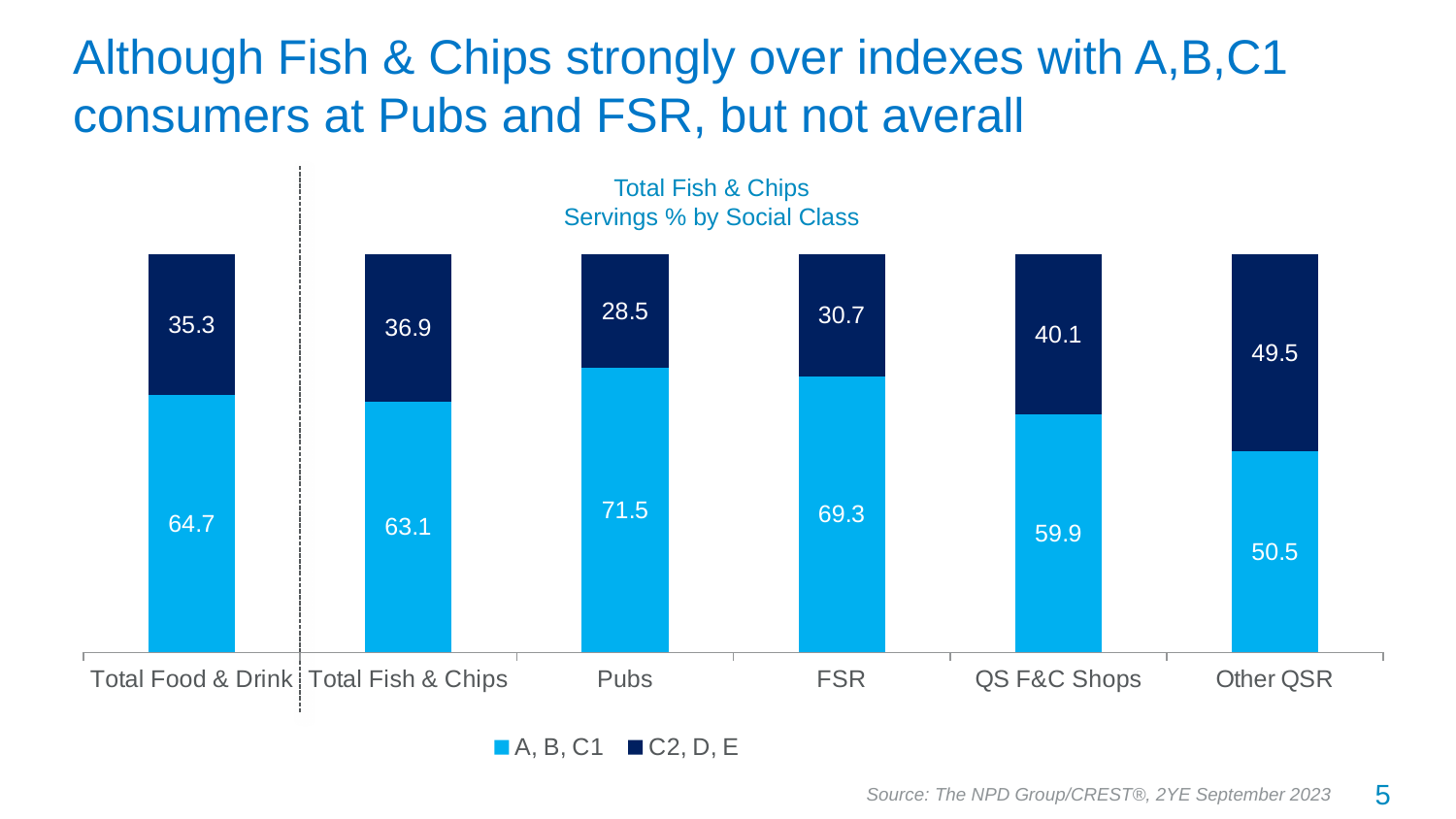
What is the title of the chart? Total Fish & Chips Servings % by Social Class How many categories are shown on the x axis? 6 Which category has the lowest C2, D, E value? Pubs What is the difference between the A, B, C1 values for Pubs and Other QSR? 21 What kind of chart is shown? Stacked bar chart How many series does the legend list? 2 Which is larger, the C2, D, E value for QS F&C Shops or for FSR? QS F&C Shops What is the total of the stacked bar for Total Food & Drink? 100 What is the A, B, C1 value for Total Fish & Chips? 63.1 What is the A, B, C1 value for Pubs? 71.5 What is the C2, D, E value for Other QSR? 49.5 Which category has the highest A, B, C1 value? Pubs